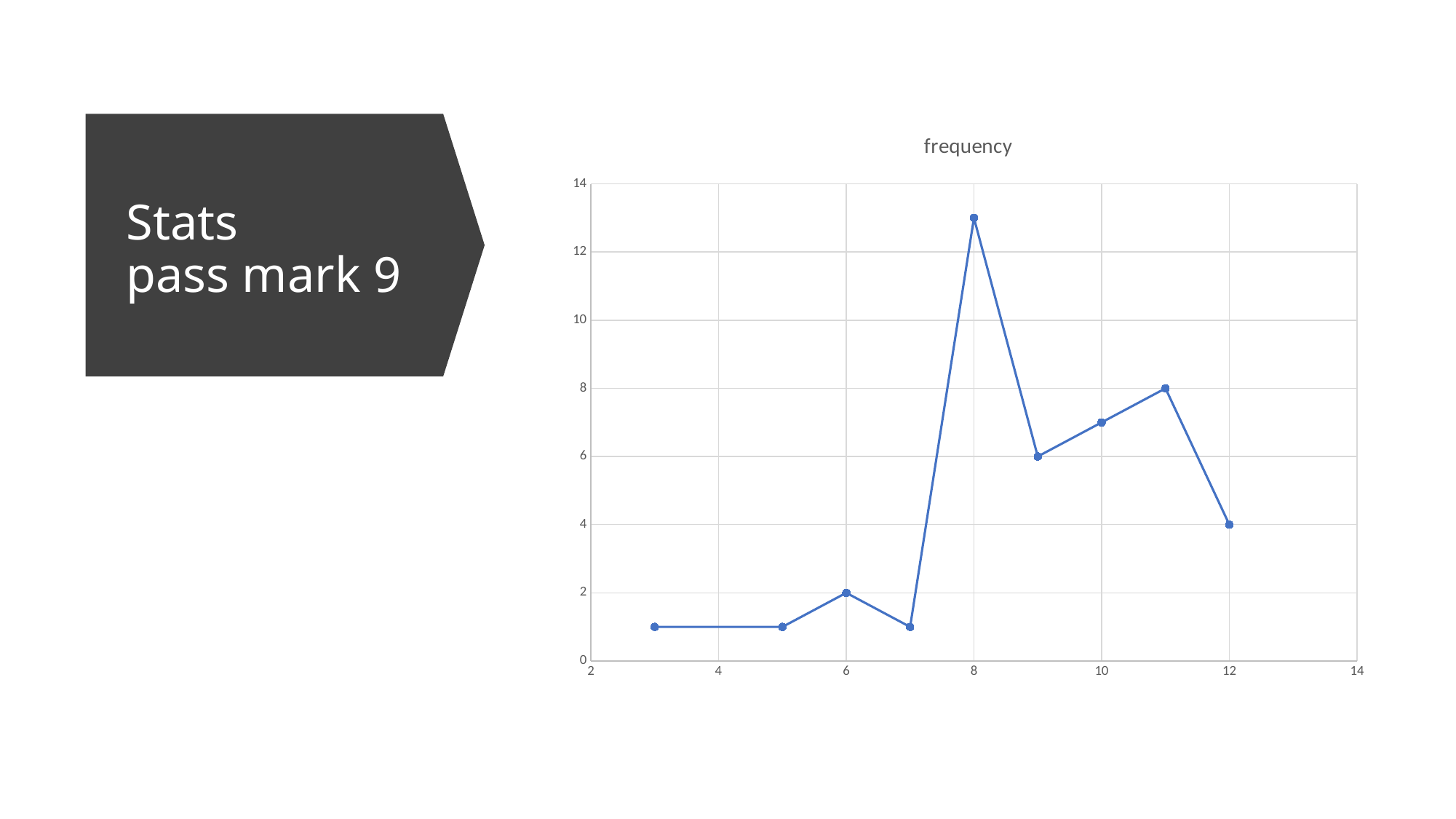
At which x value does the line reach its highest point? 8 Is the value at x = 10 greater or less than 8? less Which is larger, the value at x = 8 or the value at x = 12? x = 8 What is the value at x = 6? 2 What is the value at x = 12? 4 What is the title of the chart? frequency How many data points are plotted on the line? 9 Is the value at x = 10 greater or less than 6? greater What is the difference between the value at x = 12 and the value at x = 6? 2 Is the value at x = 8 greater or less than 12? greater What is the highest value shown on the vertical axis? 14 What type of chart is shown on the slide? line chart